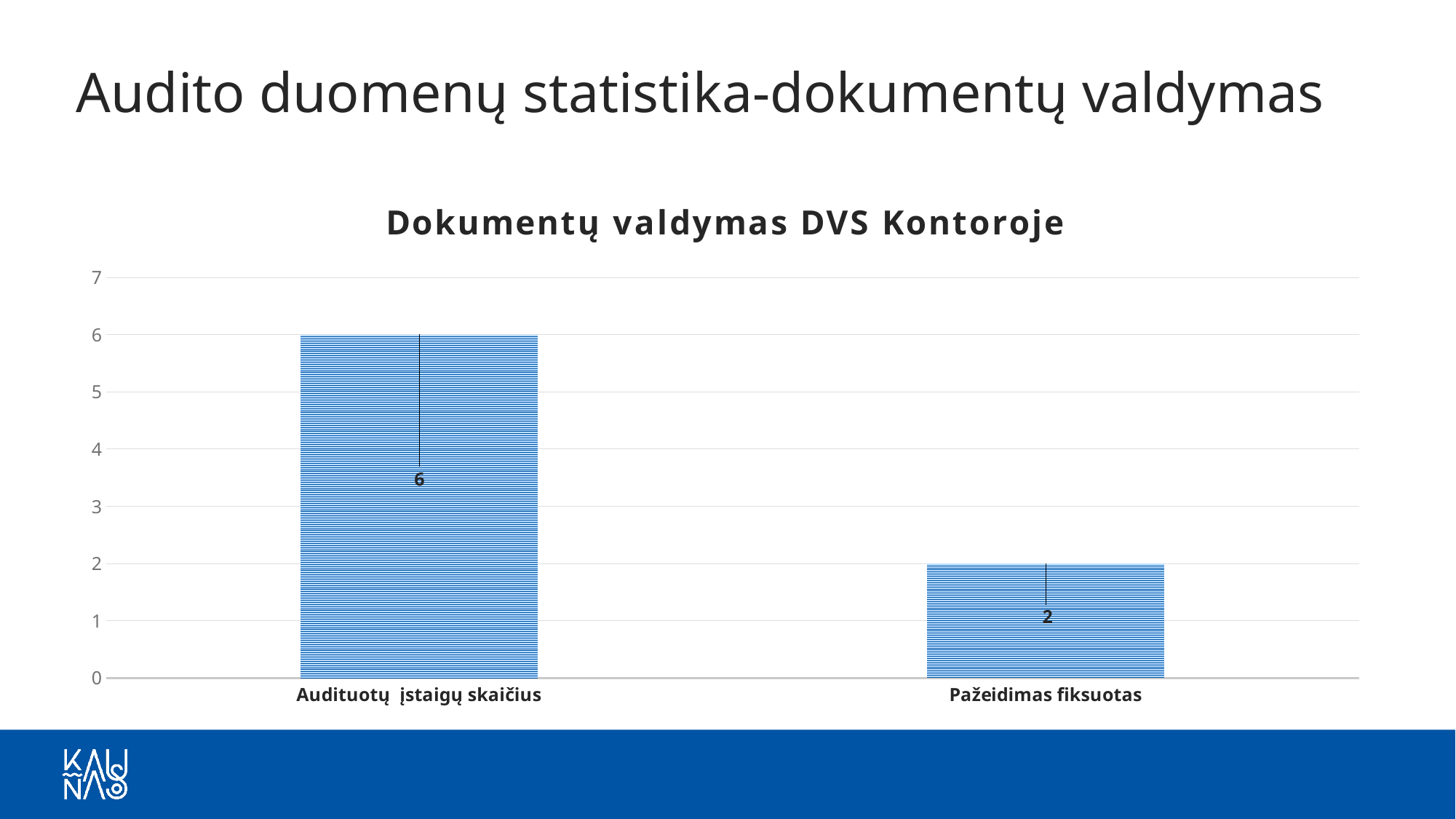
What is the difference between the values for "Audituotų įstaigų skaičius" and "Pažeidimas fiksuotas"? 4 Which category has the lowest value? Pažeidimas fiksuotas What is the value for "Pažeidimas fiksuotas"? 2 What is the value for "Audituotų įstaigų skaičius"? 6 What is the title of the chart? Dokumentų valdymas DVS Kontoroje Which is larger: the value for "Audituotų įstaigų skaičius" or for "Pažeidimas fiksuotas"? Audituotų įstaigų skaičius Is the value for "Pažeidimas fiksuotas" greater or less than 3? less How many categories are shown in the chart? 2 Which category has the highest value? Audituotų įstaigų skaičius Is the value for "Audituotų įstaigų skaičius" greater or less than 5? greater What kind of chart is shown on the slide? bar chart What is the highest value shown on the vertical axis? 7